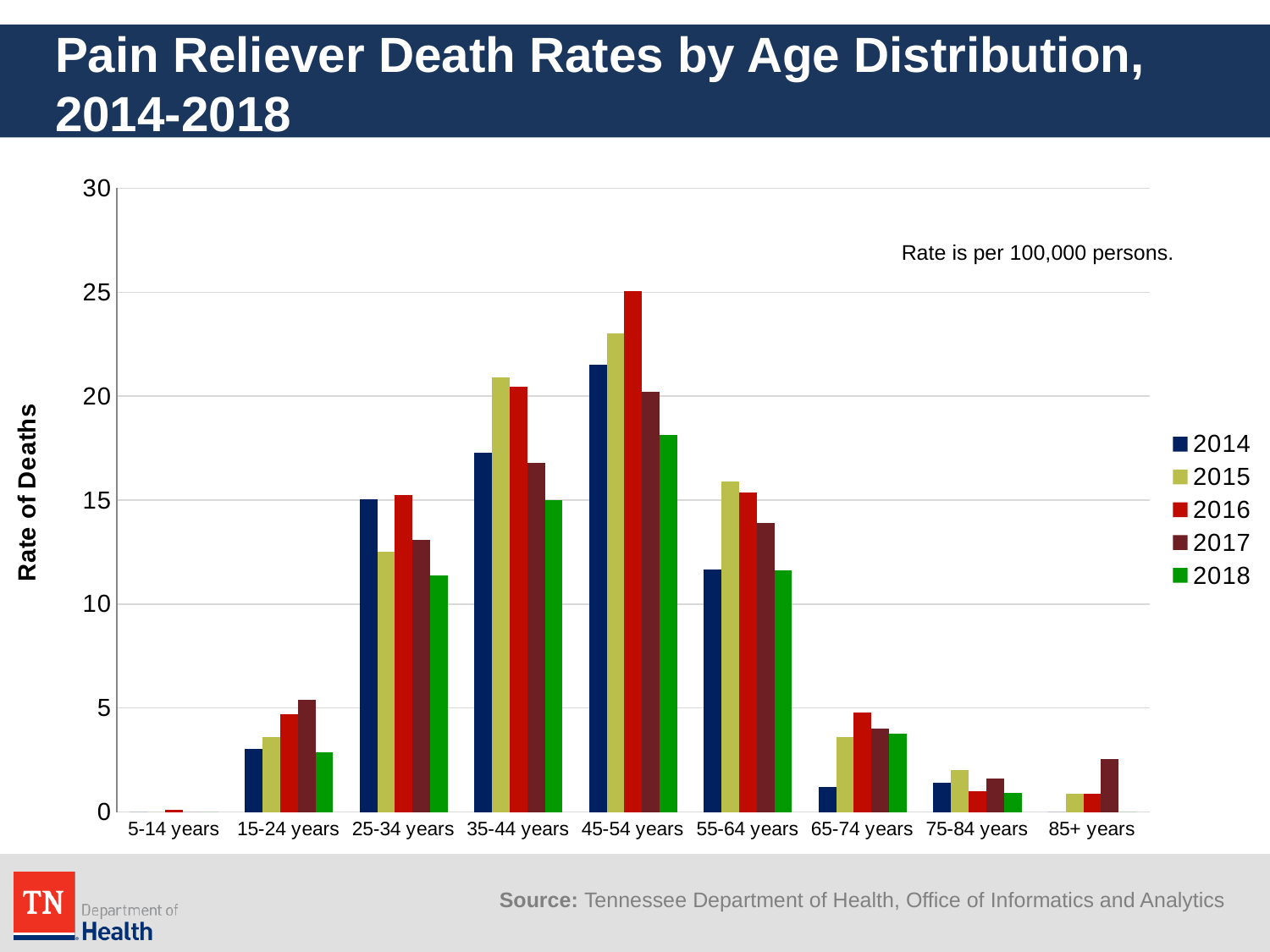
What kind of chart is shown on the slide? bar chart For 25-34 years, which is larger: the 2014 value or the 2015 value? 2014 Is the 2018 value for 25-34 years greater or less than 15? less Is the 2016 value for 45-54 years greater or less than 20? greater How many series does the legend list? 5 For 45-54 years, which is larger: the 2017 value or the 2018 value? 2017 Within the 45-54 years age group, which year has the highest bar? 2016 What is the label on the y axis? Rate of Deaths Which age group has the lowest death rates across all years? 5-14 years How many age groups are shown on the x axis? 9 Is the 2014 value for 35-44 years greater or less than 15? greater Which age group has the highest death rate for 2016? 45-54 years